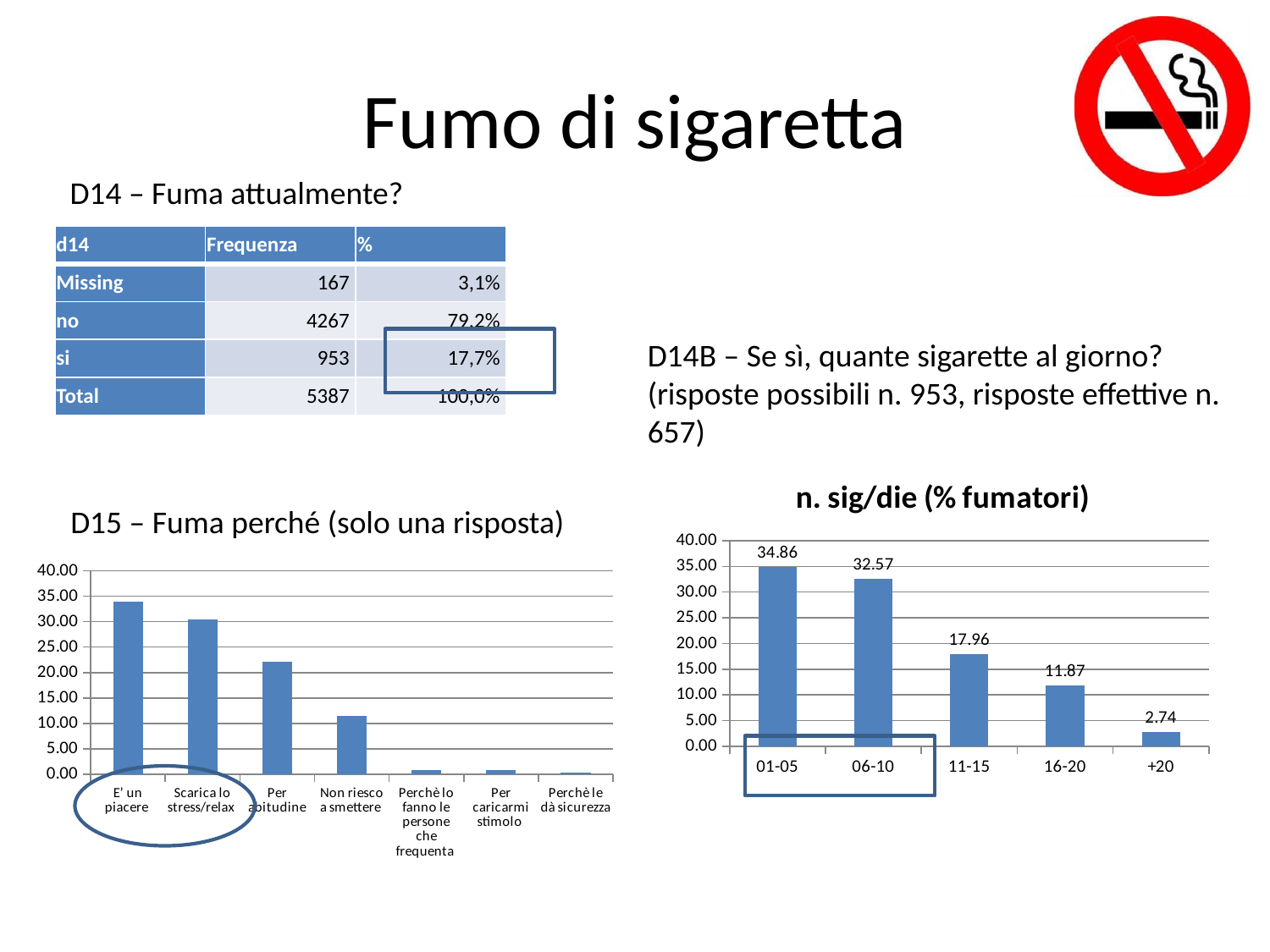
What kind of chart is the one titled "n. sig/die (% fumatori)"? bar chart In the chart titled "n. sig/die (% fumatori)", what is the difference between the values for 01-05 and 06-10? 2.29 In the chart under "D15 – Fuma perché (solo una risposta)", which category has the highest value? E' un piacere In the chart titled "n. sig/die (% fumatori)", what is the value for the 16-20 category? 11.87 In the chart titled "n. sig/die (% fumatori)", how many categories are shown on the x axis? 5 In the chart titled "n. sig/die (% fumatori)", which category has the lowest value? +20 In the chart titled "n. sig/die (% fumatori)", do the values rise or fall from left to right along the x axis? fall In the chart under "D15 – Fuma perché (solo una risposta)", is the value for "Per abitudine" greater or less than 20.00? greater In the chart titled "n. sig/die (% fumatori)", what is the value for the 01-05 category? 34.86 In the chart under "D15 – Fuma perché (solo una risposta)", which is larger: the value for "Scarica lo stress/relax" or the value for "Non riesco a smettere"? Scarica lo stress/relax In the chart under "D15 – Fuma perché (solo una risposta)", how many categories are shown on the x axis? 7 In the chart titled "n. sig/die (% fumatori)", which category has the highest value? 01-05